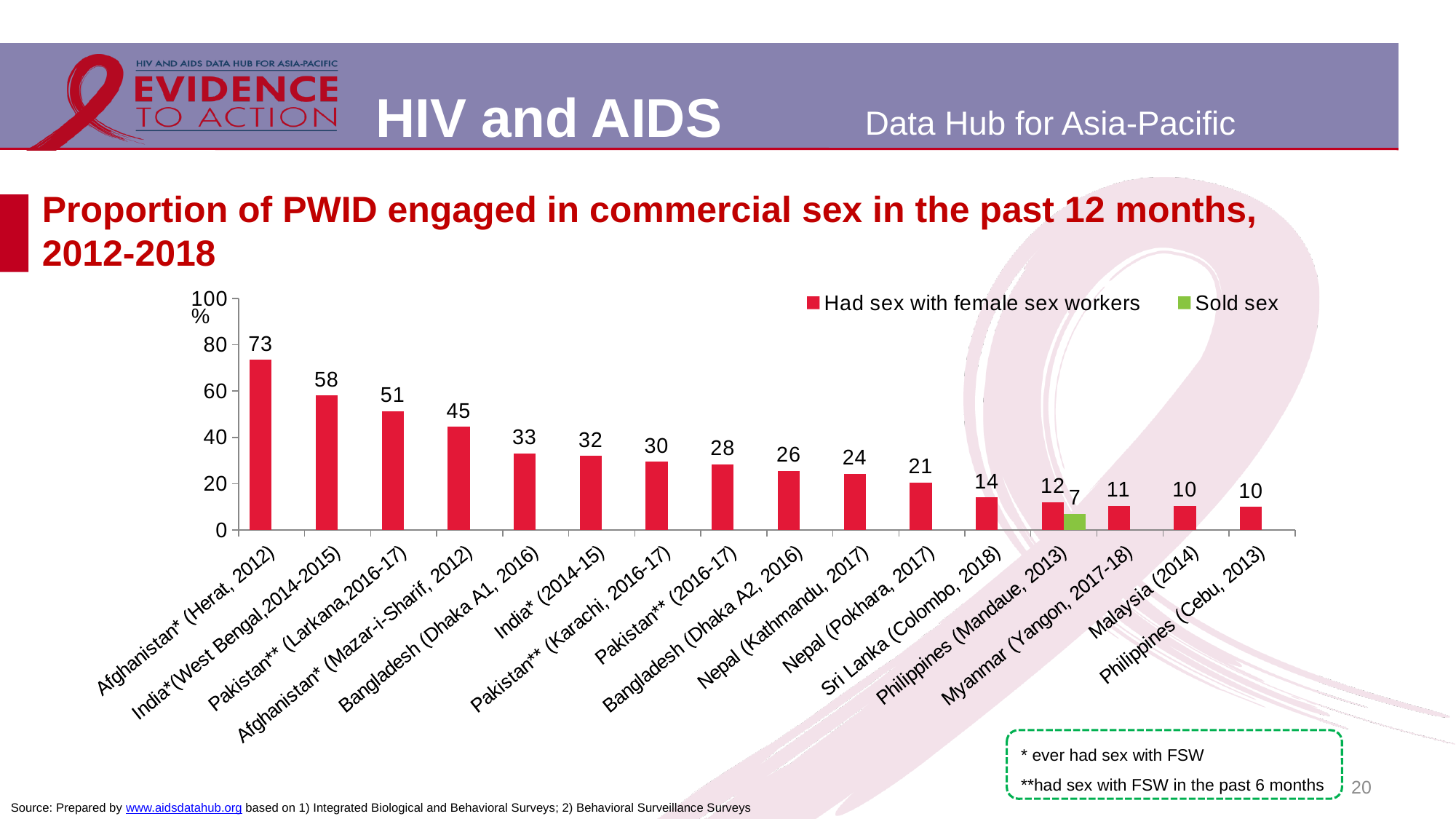
What kind of chart is shown on the slide? Bar chart Which has a higher 'Had sex with female sex workers' value: Nepal (Kathmandu, 2017) or Myanmar (Yangon, 2017-18)? Nepal (Kathmandu, 2017) What is the 'Sold sex' value for Philippines (Mandaue, 2013)? 7 How many categories are shown on the x axis of the chart? 16 What is the value for 'Had sex with female sex workers' for Pakistan** (Larkana,2016-17)? 51 What is the value for 'Had sex with female sex workers' for Afghanistan* (Herat, 2012)? 73 What is the value for 'Had sex with female sex workers' for Sri Lanka (Colombo, 2018)? 14 What is the difference between the 'Had sex with female sex workers' values for India*(West Bengal,2014-2015) and Afghanistan* (Mazar-i-Sharif, 2012)? 13 Do the 'Had sex with female sex workers' values rise or fall from left to right along the x axis? Fall Which category has the highest value for 'Had sex with female sex workers'? Afghanistan* (Herat, 2012) Which category is the only one with a 'Sold sex' bar? Philippines (Mandaue, 2013) How many series does the legend list? 2